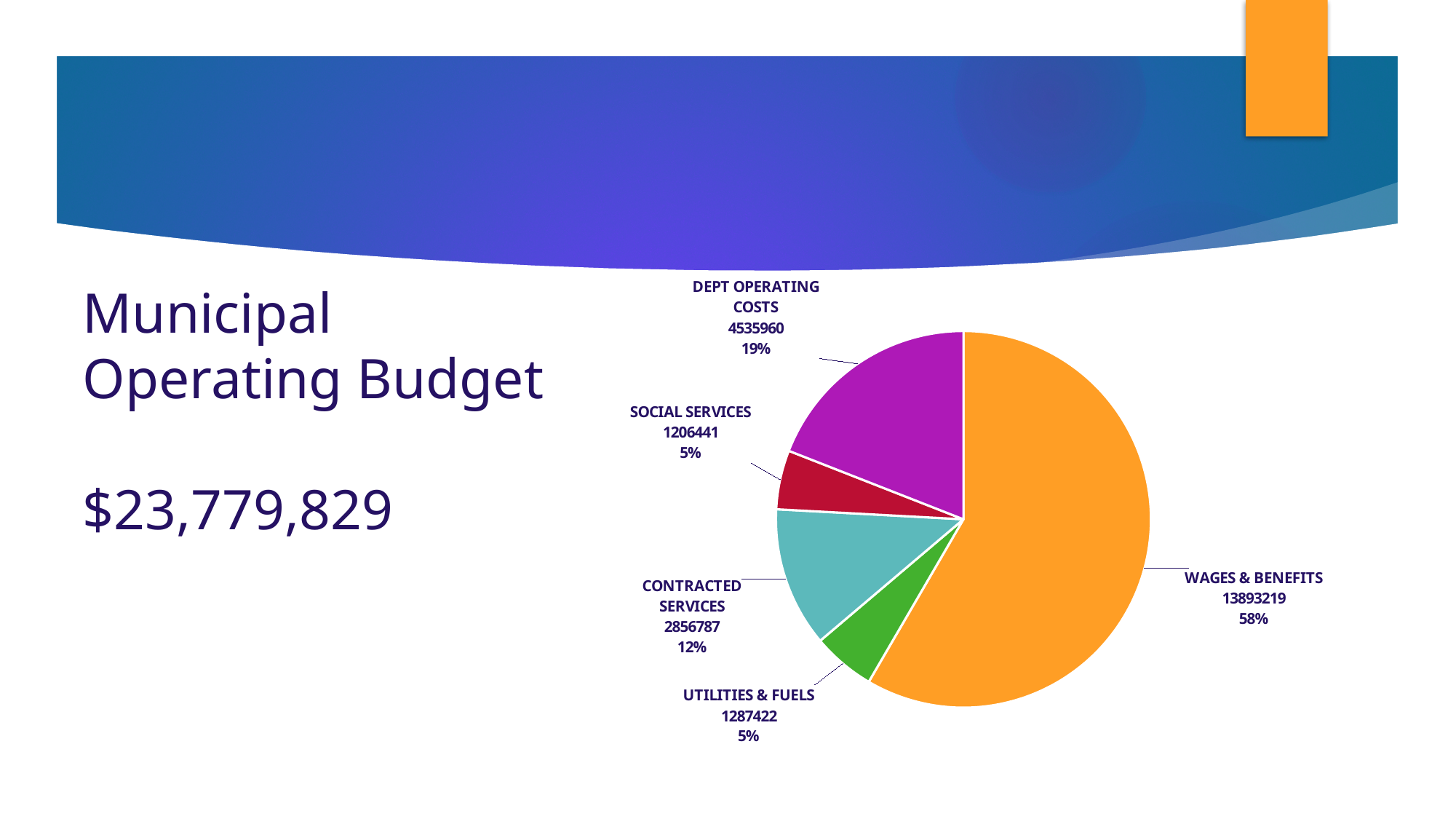
Which category has the largest slice of the pie? Wages & Benefits What share of the pie does Contracted Services represent? 12% Which category has the smallest value in the pie chart? Social Services What total budget figure is printed on the slide next to the chart? $23,779,829 What kind of chart is shown on the slide? Pie chart What is the value for Dept Operating Costs? 4535960 Which is larger, Utilities & Fuels or Social Services? Utilities & Fuels What is the difference between the values for Dept Operating Costs and Contracted Services? 1679173 How many slices does the pie chart have? 5 What is the value for Wages & Benefits? 13893219 What share of the pie does Wages & Benefits represent? 58% What is the value for Contracted Services? 2856787